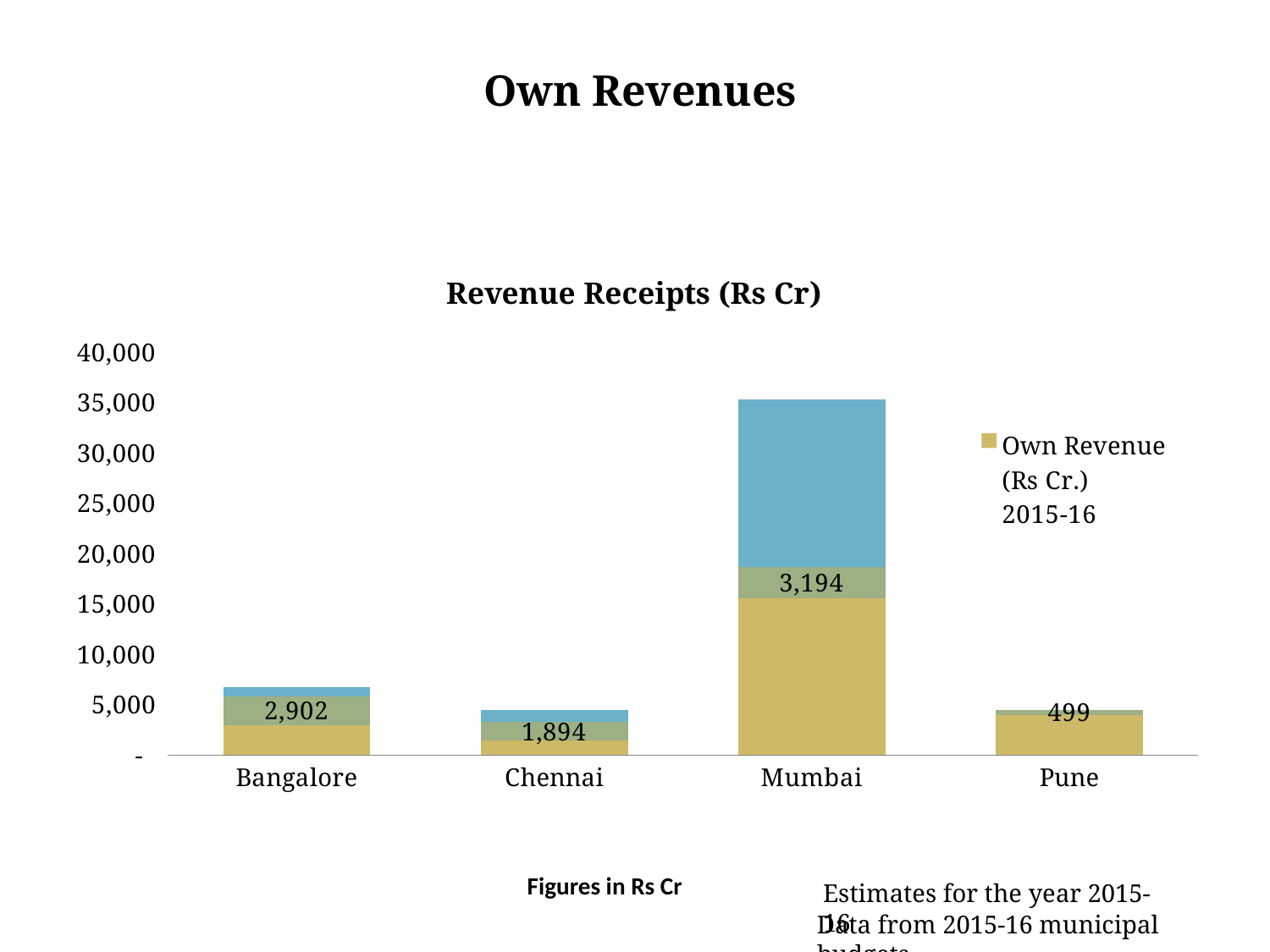
What is the difference between the data labels printed for Bangalore and Chennai? 1,008 Which city has the tallest stacked bar in the chart? Mumbai Is the total height of the Mumbai stacked bar greater or less than 30,000? greater Which city has the smallest printed data label? Pune What data label is printed on the Chennai bar? 1,894 What data label is printed on the Bangalore bar? 2,902 How many cities are shown on the x axis of the chart? 4 What entry does the chart legend list? Own Revenue (Rs Cr.) 2015-16 What kind of chart is shown on the slide? bar chart What data label is printed on the Pune bar? 499 What is the title of the chart? Revenue Receipts (Rs Cr) What data label is printed on the Mumbai bar? 3,194